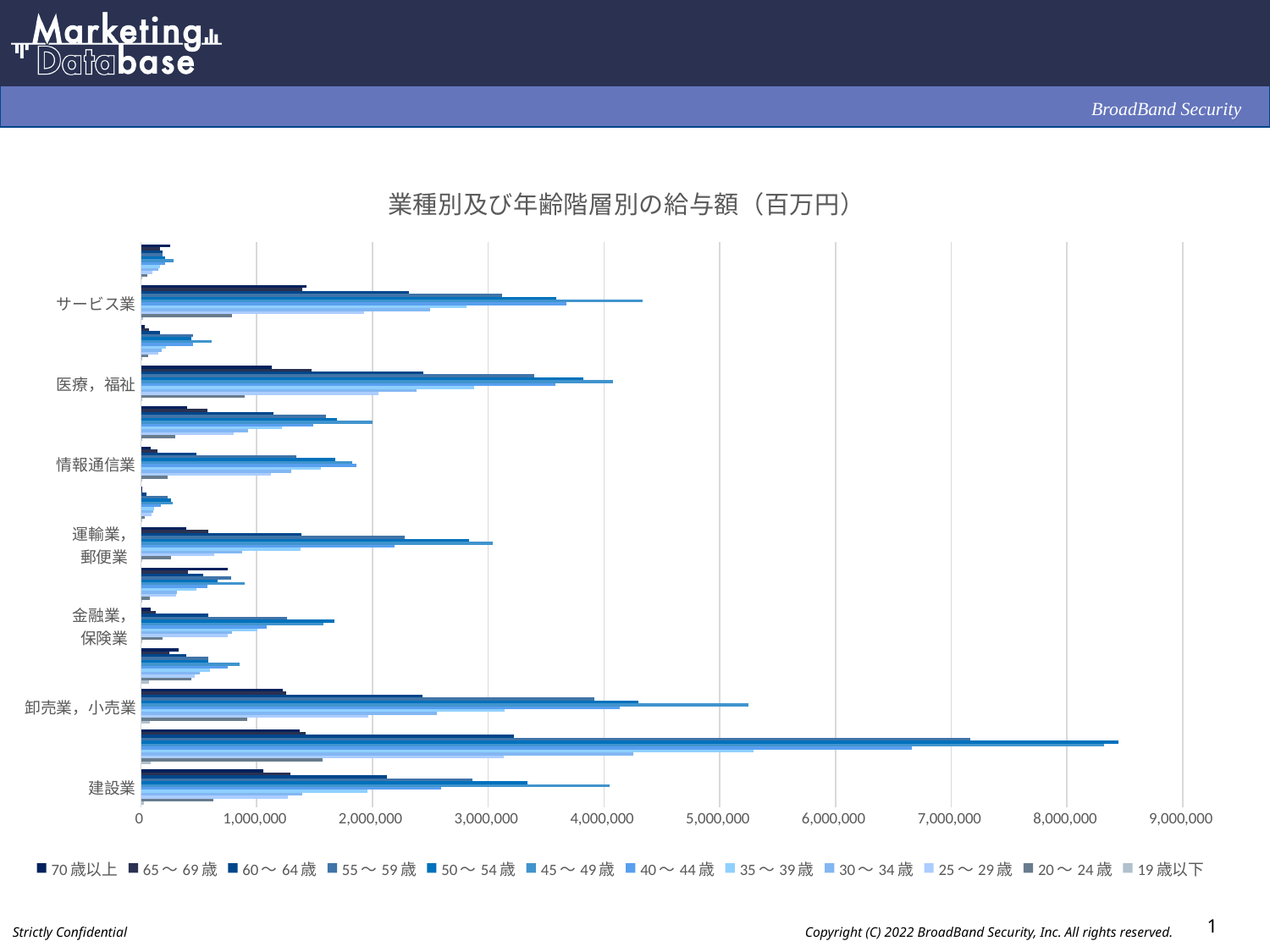
Is the longest bar on the entire chart greater or less than 8,000,000? greater Is the longest bar for 建設業 greater or less than 3,000,000? greater What kind of chart is shown on the slide? bar chart Which has the longer longest bar, 医療，福祉 or 情報通信業? 医療，福祉 Is the longest bar for 卸売業，小売業 greater or less than 5,000,000? greater What is the highest value shown on the horizontal axis? 9,000,000 What is the title of the chart? 業種別及び年齢階層別の給与額（百万円） Which has the longer longest bar, 卸売業，小売業 or サービス業? 卸売業，小売業 How many series does the legend list? 12